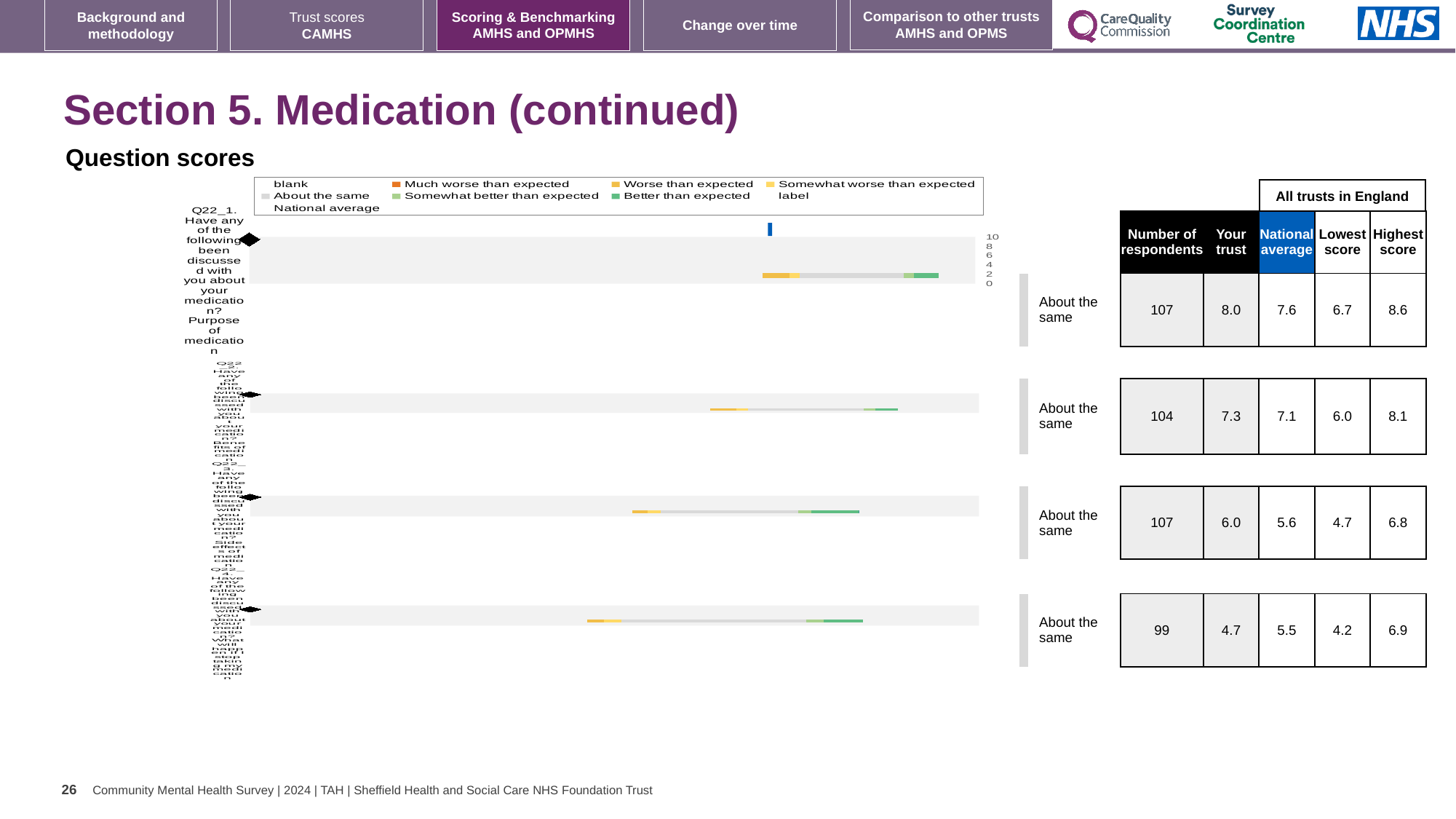
What is the difference between the 'Your trust' score and the national average for Q22_1 (Purpose of medication)? 0.4 What is the national average score for Q22_3 (Side effects of medication)? 5.6 For Q22_4, which is larger: the 'Your trust' score or the national average? National average What kind of chart is shown on the slide? Bar chart Which question has the highest 'Your trust' score? Q22_1 Purpose of medication What is the 'Your trust' score for Q22_1 (Purpose of medication)? 8.0 What is the highest score among all trusts in England for Q22_2 (Benefits of medication)? 8.1 How many question rows (categories) are plotted in the chart? 4 What is the highest tick value shown on the chart's score axis? 10 What colour does the legend use for 'Better than expected'? Green Which question has the lowest 'Your trust' score? Q22_4 What will happen if I stop taking my medication How many respondents are listed for Q22_4 (What will happen if I stop taking my medication)? 99